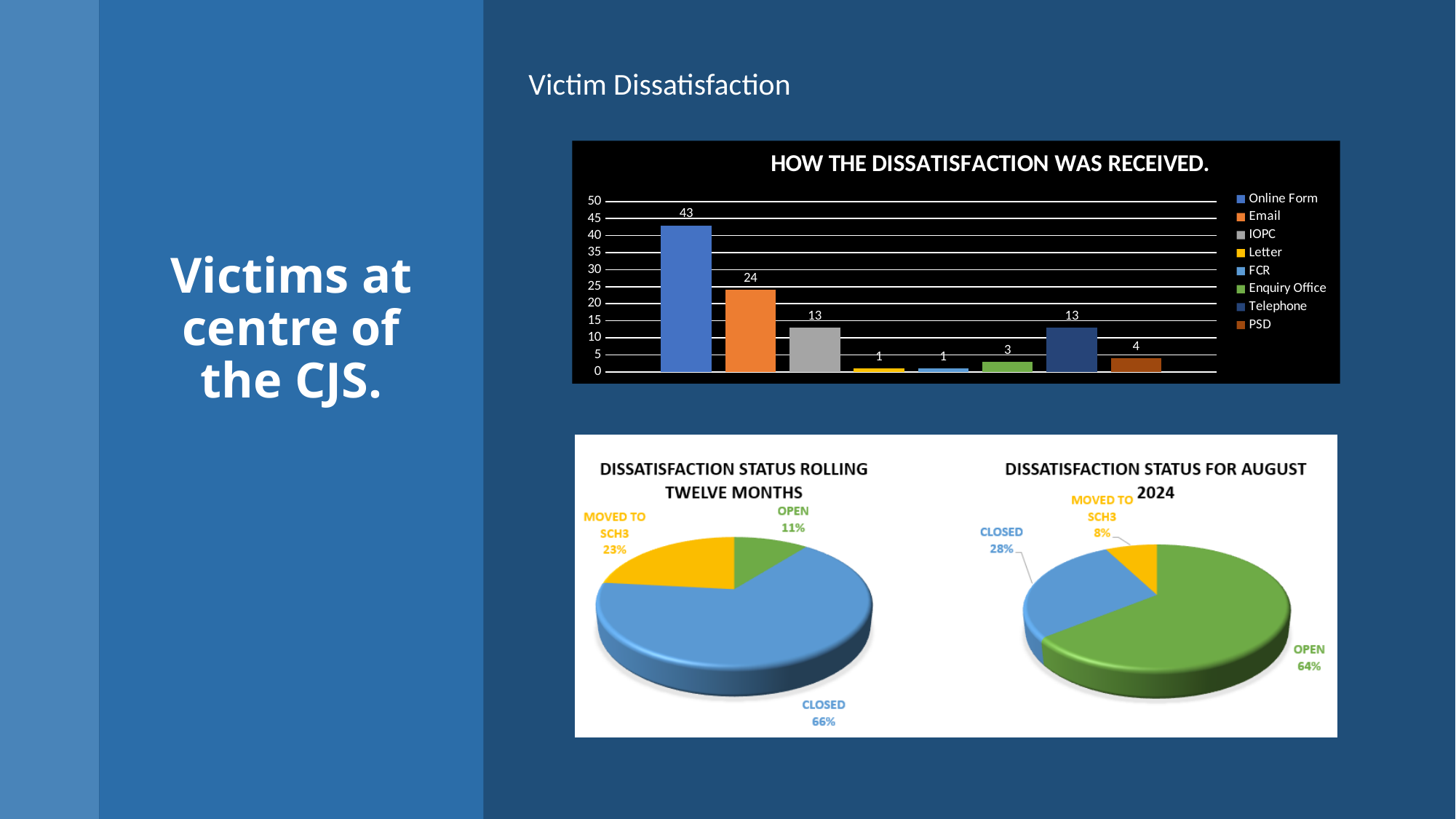
What kind of chart is 'HOW THE DISSATISFACTION WAS RECEIVED.'? Bar chart In the chart 'DISSATISFACTION STATUS FOR AUGUST 2024', what share of the pie is Closed? 28% How many series does the legend of the chart 'HOW THE DISSATISFACTION WAS RECEIVED.' list? 8 In the chart 'DISSATISFACTION STATUS ROLLING TWELVE MONTHS', what share of the pie is Closed? 66% In the chart 'HOW THE DISSATISFACTION WAS RECEIVED.', which is larger, the value for PSD or the value for Enquiry Office? PSD In the chart 'HOW THE DISSATISFACTION WAS RECEIVED.', what is the value for Telephone? 13 In the chart 'DISSATISFACTION STATUS FOR AUGUST 2024', which slice is the largest? Open In the chart 'HOW THE DISSATISFACTION WAS RECEIVED.', which category has the highest value? Online Form In the chart 'HOW THE DISSATISFACTION WAS RECEIVED.', what is the value for Online Form? 43 In the chart 'HOW THE DISSATISFACTION WAS RECEIVED.', what is the value for Email? 24 In the chart 'DISSATISFACTION STATUS ROLLING TWELVE MONTHS', what share of the pie is Moved to SCH3? 23% In the chart 'HOW THE DISSATISFACTION WAS RECEIVED.', what is the difference between the values for Online Form and Email? 19